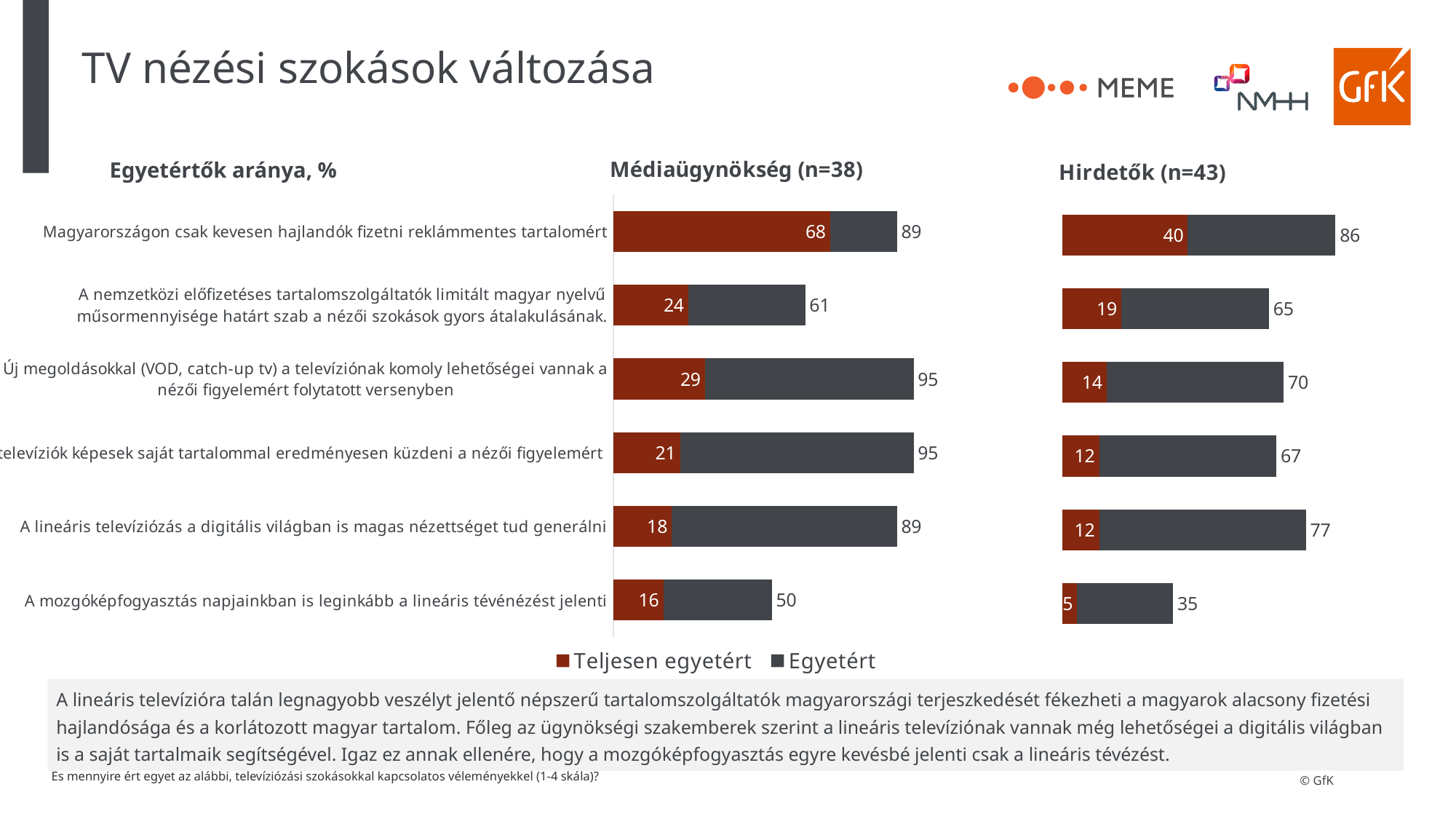
In the Médiaügynökség (n=38) chart, what is the 'Teljesen egyetért' value for 'Magyarországon csak kevesen hajlandók fizetni reklámmentes tartalomért'? 68 In the Médiaügynökség (n=38) chart, what is the difference between the 'Teljesen egyetért' values for 'Magyarországon csak kevesen hajlandók fizetni reklámmentes tartalomért' and 'A nemzetközi előfizetéses tartalomszolgáltatók...' statement? 44 In the Hirdetők (n=43) chart, which statement has the highest 'Teljesen egyetért' value? Magyarországon csak kevesen hajlandók fizetni reklámmentes tartalomért In the Hirdetők (n=43) chart, which has the larger total value: 'A lineáris televíziózás a digitális világban is magas nézettséget tud generálni' or 'Új megoldásokkal (VOD, catch-up tv) a televíziónak komoly lehetőségei vannak a nézői figyelemért folytatott versenyben'? A lineáris televíziózás a digitális világban is magas nézettséget tud generálni In the Hirdetők (n=43) chart, what is the 'Teljesen egyetért' value for 'A nemzetközi előfizetéses tartalomszolgáltatók limitált magyar nyelvű műsormennyisége határt szab a nézői szokások gyors átalakulásának'? 19 In the Médiaügynökség (n=38) chart, which statement has the lowest total value at the end of its bar? A mozgóképfogyasztás napjainkban is leginkább a lineáris tévénézést jelenti What kind of chart is the Hirdetők (n=43) chart? Horizontal bar chart For 'Magyarországon csak kevesen hajlandók fizetni reklámmentes tartalomért', what is the difference between the total value in the Médiaügynökség (n=38) chart and the total value in the Hirdetők (n=43) chart? 3 How many statements (categories) are shown in the Médiaügynökség (n=38) chart? 6 How many series does the legend list for the charts? 2 What are the two legend entries shown below the charts? Teljesen egyetért, Egyetért In the Hirdetők (n=43) chart, what is the total value shown at the end of the bar for 'A mozgóképfogyasztás napjainkban is leginkább a lineáris tévénézést jelenti'? 35